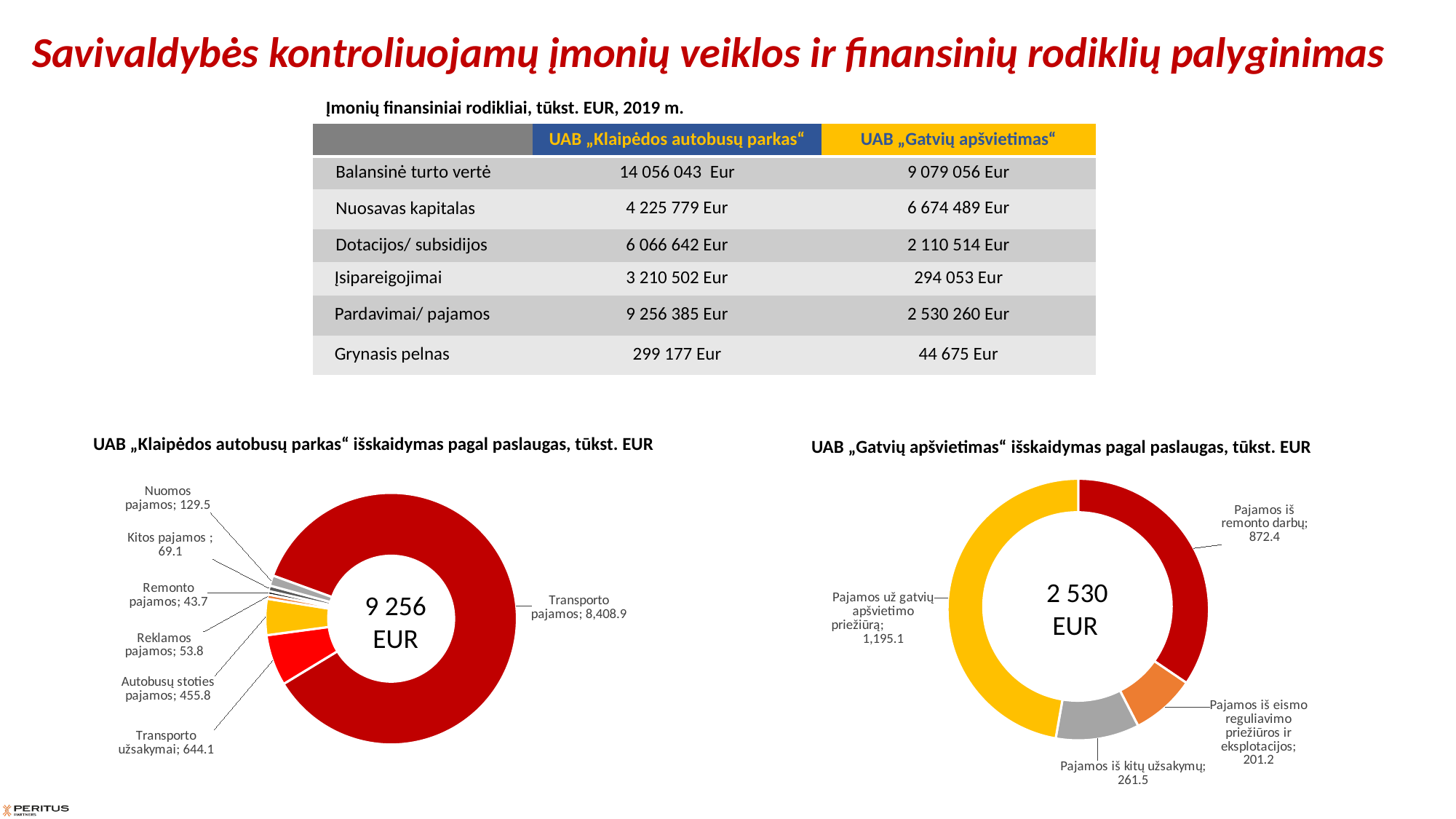
In the UAB „Klaipėdos autobusų parkas“ chart, what is the difference between Transporto užsakymai and Autobusų stoties pajamos? 188.3 In the UAB „Gatvių apšvietimas“ chart, which category has the highest value? Pajamos už gatvių apšvietimo priežiūrą What type of chart is used for the UAB „Gatvių apšvietimas“ breakdown? Donut chart In the UAB „Klaipėdos autobusų parkas“ chart, which category has the lowest value? Remonto pajamos In the UAB „Gatvių apšvietimas“ chart, which category has the lowest value? Pajamos iš eismo reguliavimo priežiūros ir eksplotacijos In the UAB „Gatvių apšvietimas“ chart, what is the value for Pajamos iš remonto darbų? 872.4 How many categories are shown in the UAB „Gatvių apšvietimas“ chart? 4 In the UAB „Klaipėdos autobusų parkas“ chart, what is the value for Autobusų stoties pajamos? 455.8 In the UAB „Gatvių apšvietimas“ chart, what is the difference between Pajamos už gatvių apšvietimo priežiūrą and Pajamos iš remonto darbų? 322.7 How many categories are shown in the UAB „Klaipėdos autobusų parkas“ chart? 7 In the UAB „Klaipėdos autobusų parkas“ chart, what is the value for Transporto pajamos? 8,408.9 In the UAB „Klaipėdos autobusų parkas“ chart, which is larger: Nuomos pajamos or Kitos pajamos? Nuomos pajamos